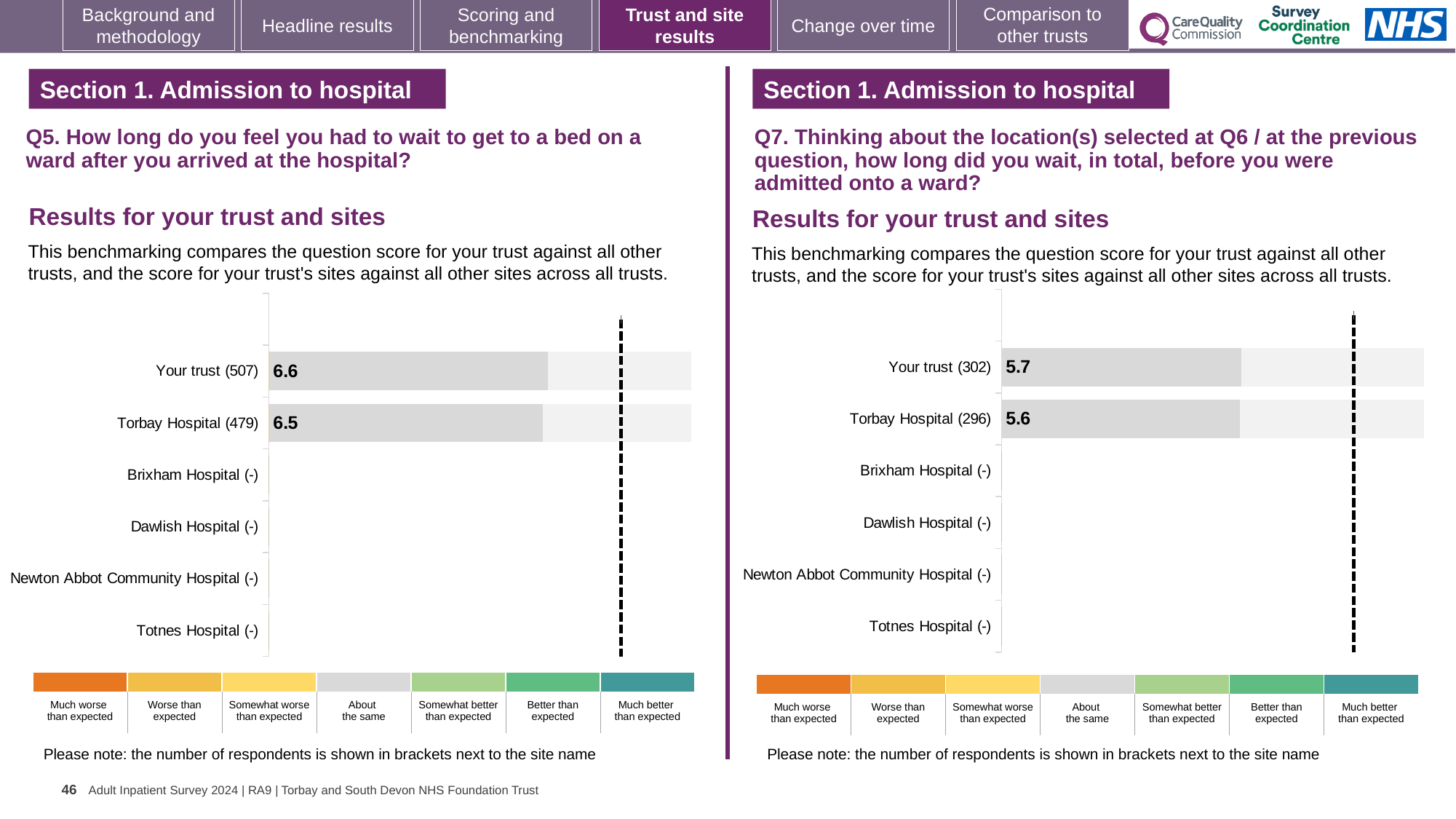
In the Q7 chart on the right, what is the difference between the scores for Your trust and Torbay Hospital? 0.1 In the Q5 chart on the left, how many respondents are shown in brackets for Torbay Hospital? 479 In the Q7 chart on the right, what is the score for Torbay Hospital (296)? 5.6 In the Q7 chart on the right, what is the score for Your trust (302)? 5.7 How many site/trust categories are listed on the y axis of the Q5 chart on the left? 6 In the Q7 chart on the right, which has the higher score, Your trust or Torbay Hospital? Your trust In the Q5 chart on the left, what is the score for Your trust (507)? 6.6 In the Q5 chart on the left, what is the difference between the scores for Your trust and Torbay Hospital? 0.1 What kind of chart is the Q7 chart on the right? Bar chart In the Q5 chart on the left, what is the score for Torbay Hospital (479)? 6.5 In the Q7 chart on the right, how many respondents are shown in brackets for Your trust? 302 In the Q5 chart on the left, which has the higher score, Your trust or Torbay Hospital? Your trust